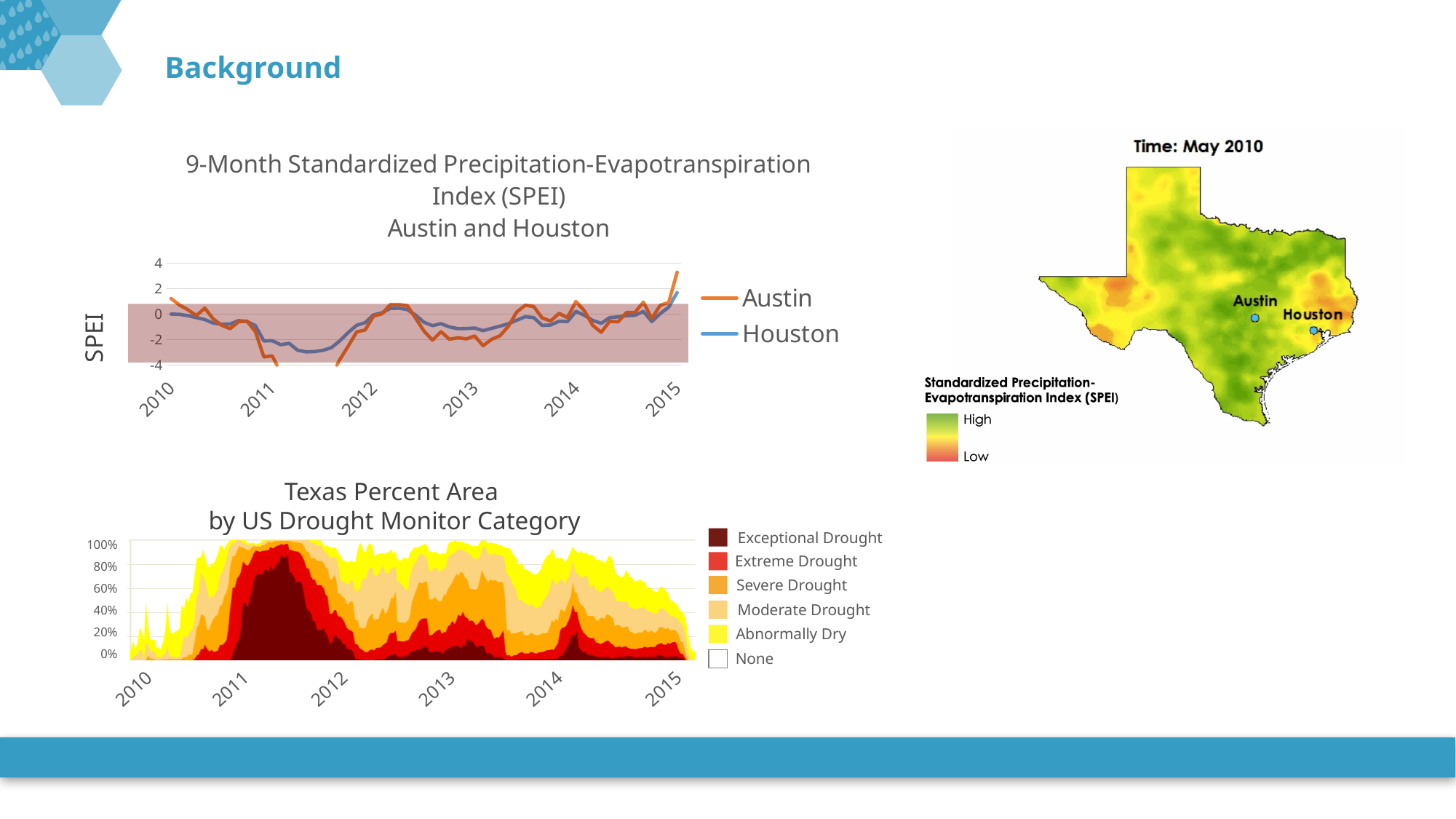
How many categories does the legend of the 'Texas Percent Area by US Drought Monitor Category' chart list? 6 How many series does the legend of the SPEI Austin and Houston chart list? 2 In the SPEI Austin and Houston chart, which series dips lower in 2011, Austin or Houston? Austin In the 'Texas Percent Area by US Drought Monitor Category' chart, is the peak Exceptional Drought area in 2011 greater or less than 80%? greater What kind of chart is the '9-Month Standardized Precipitation-Evapotranspiration Index (SPEI) Austin and Houston' chart? line chart In the SPEI Austin and Houston chart, which series reaches the higher value at the end of 2015, Austin or Houston? Austin In the 'Texas Percent Area by US Drought Monitor Category' chart, which colour represents Abnormally Dry? yellow What is the y-axis label of the SPEI Austin and Houston chart? SPEI In the SPEI Austin and Houston chart, is the Austin value at the end of 2015 greater or less than 2? greater In the SPEI Austin and Houston chart, is the lowest Austin value in 2011 greater or less than -2? less What kind of chart is the 'Texas Percent Area by US Drought Monitor Category' chart? stacked area chart